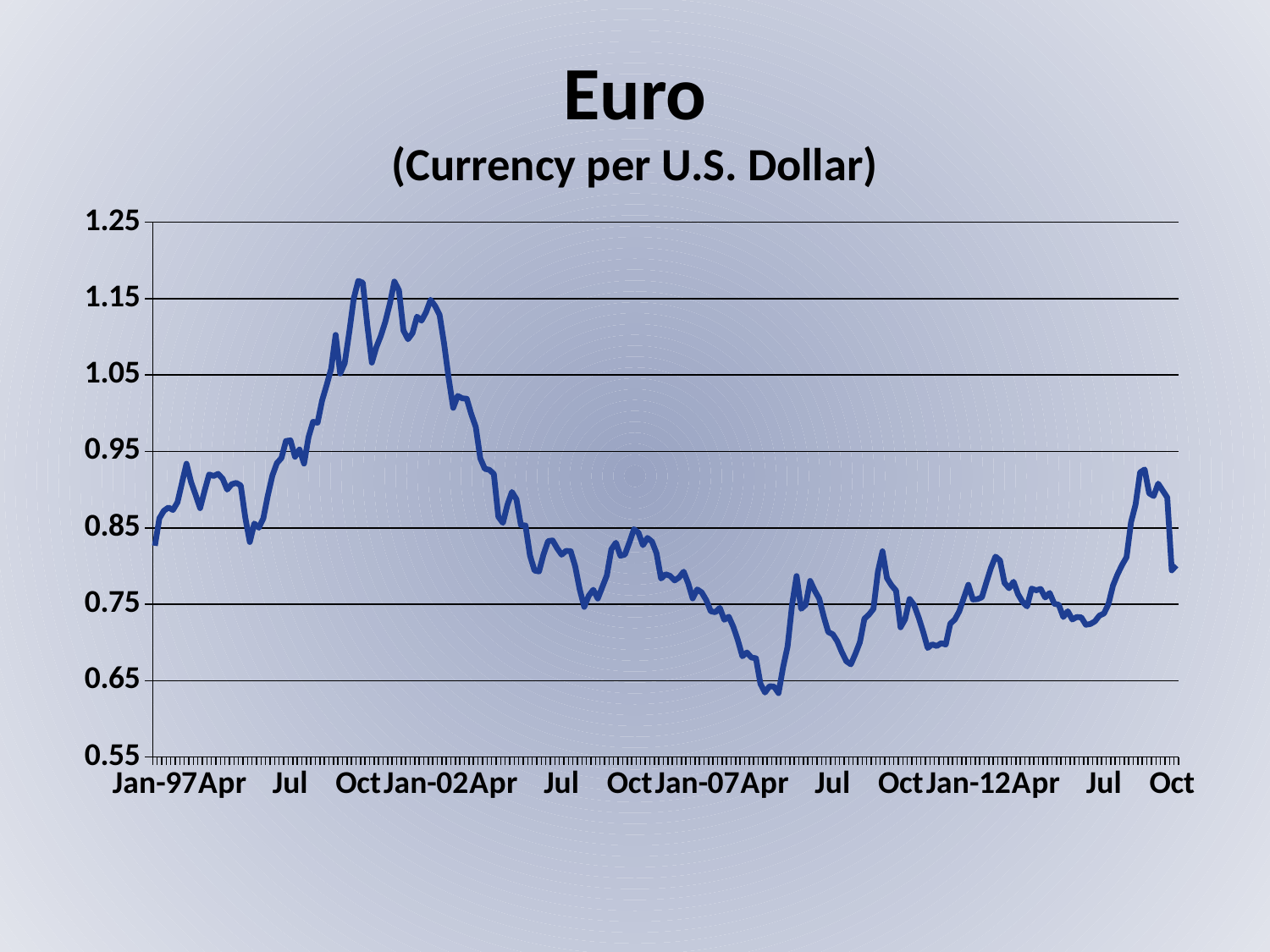
Is the lowest value on the line greater or less than 0.65? less Is the value at Jan-97 greater or less than 0.85? less Do the values generally rise or fall between Jan-02 and Jan-07? fall Is the value at Jan-02 larger or smaller than the value at Jan-12? larger Do the values generally rise or fall between Jan-97 and Jan-02? rise Is the value at Jan-02 greater or less than 1.05? greater What kind of chart is shown on the slide? line chart What is the title of the chart? Euro What unit does the chart's subtitle say the values are in? Currency per U.S. Dollar